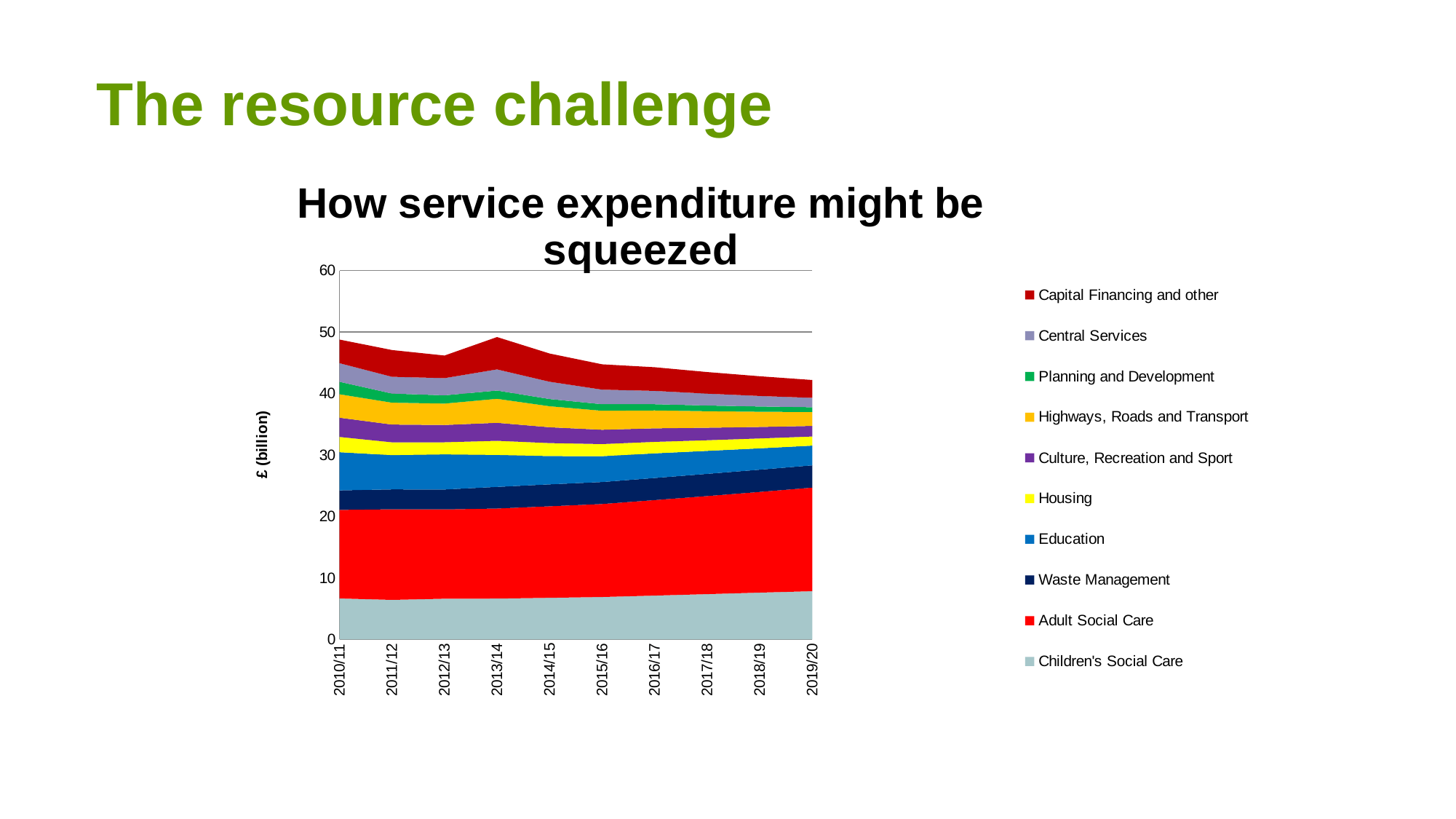
Is the value for Children's Social Care in 2019/20 greater or less than 10? less Is the total expenditure in 2019/20 greater or less than 50? less Does the total service expenditure rise or fall overall from 2010/11 to 2019/20? Fall What is the title of the chart? How service expenditure might be squeezed What is the label on the vertical axis of the chart? £ (billion) How many years are shown along the x axis of the chart? 10 How many series does the chart's legend list? 10 Is the total expenditure in 2010/11 larger or smaller than in 2019/20? Larger Is the total expenditure in 2010/11 greater or less than 40? greater Which year has the lowest total service expenditure? 2019/20 Which service area takes up the largest share of expenditure across the chart? Adult Social Care What kind of chart is shown on the slide? Stacked area chart